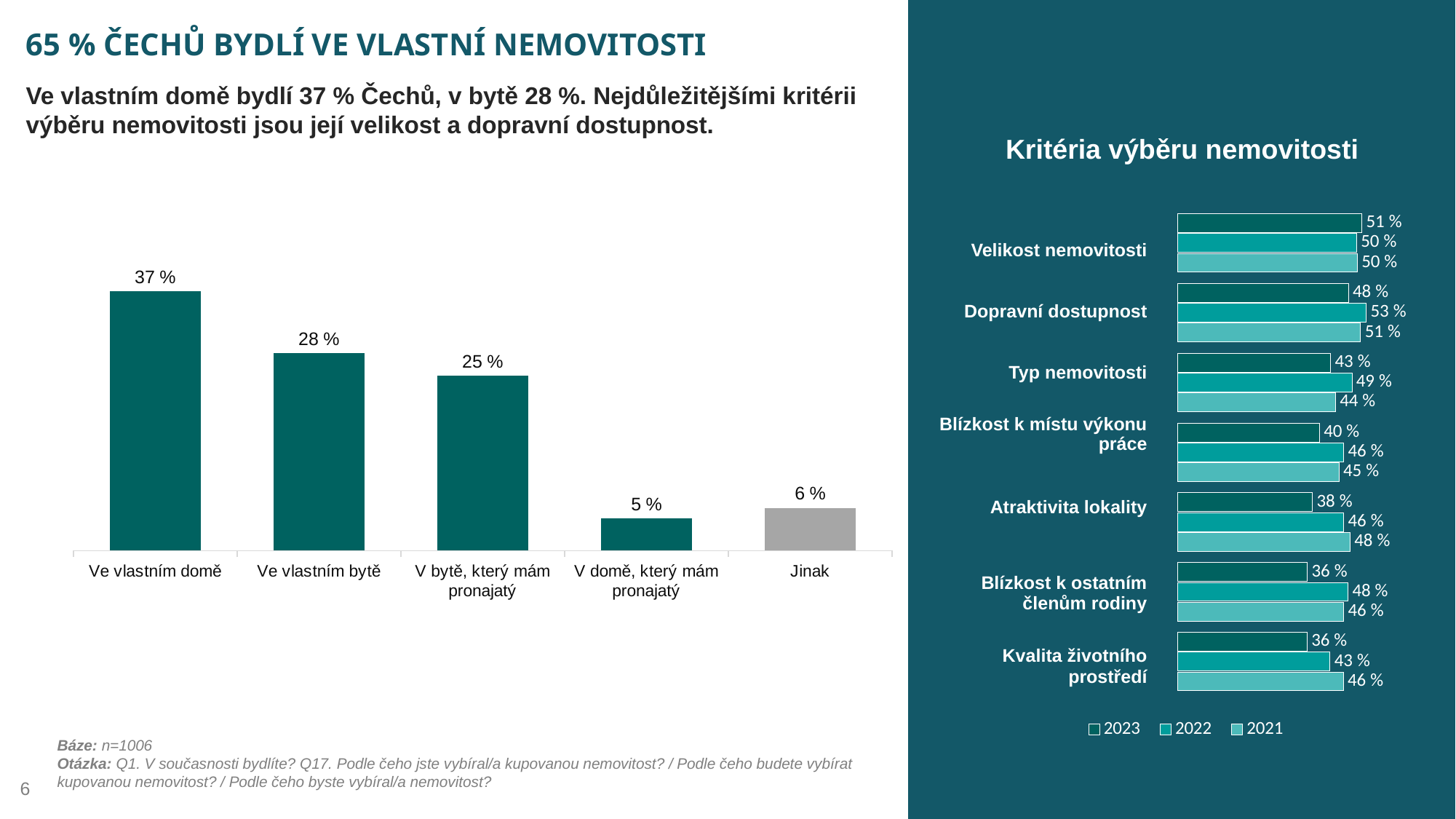
In the left chart, which is larger: 'Jinak' or 'V domě, který mám pronajatý'? Jinak In the left chart, what is the value for 'Ve vlastním domě'? 37 % What kind of chart is 'Kritéria výběru nemovitosti'? Bar chart In the chart 'Kritéria výběru nemovitosti', how many series does the legend list? 3 In the chart 'Kritéria výběru nemovitosti', what is the difference between the 2022 and 2023 values for 'Blízkost k ostatním členům rodiny'? 12 % In the chart 'Kritéria výběru nemovitosti', which criterion has the highest 2023 value? Velikost nemovitosti In the chart 'Kritéria výběru nemovitosti', what is the 2021 value for 'Kvalita životního prostředí'? 46 % In the left chart, which category has the lowest value? V domě, který mám pronajatý In the chart 'Kritéria výběru nemovitosti', what is the 2022 value for 'Dopravní dostupnost'? 53 % In the left chart, how many categories are shown? 5 In the left chart, what is the difference between 'Ve vlastním domě' and 'Ve vlastním bytě'? 9 % In the chart 'Kritéria výběru nemovitosti', how many criteria are listed? 7